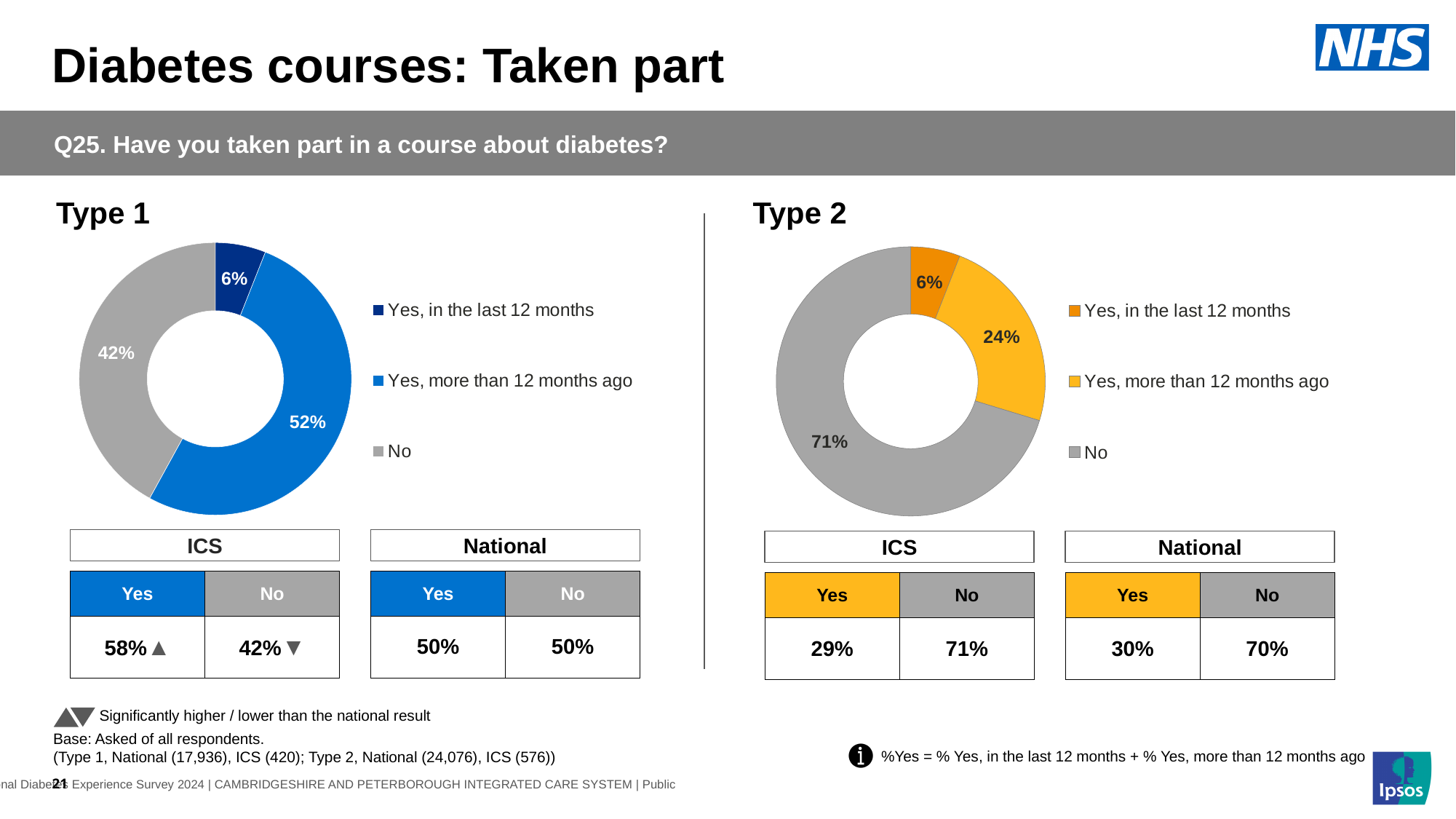
In the Type 1 chart, what colour represents 'No'? Grey In the Type 1 chart, what percentage of respondents answered 'Yes, in the last 12 months'? 6% How many categories does the Type 2 chart's legend list? 3 In the Type 2 chart, which is larger: the 'No' share or the 'Yes, more than 12 months ago' share? No In the Type 1 chart, what percentage of respondents answered 'Yes, more than 12 months ago'? 52% In the Type 1 chart, which response has the largest share? Yes, more than 12 months ago In the Type 1 chart, what is the difference between the 'No' share and the 'Yes, in the last 12 months' share? 36% What kind of chart is used for Type 1? Doughnut chart In the Type 2 chart, what percentage of respondents answered 'Yes, more than 12 months ago'? 24% In the Type 2 chart, which response has the smallest share? Yes, in the last 12 months In the Type 2 chart, what percentage of respondents answered 'No'? 71% In the Type 2 chart, what is the combined share of the two 'Yes' responses? 30%